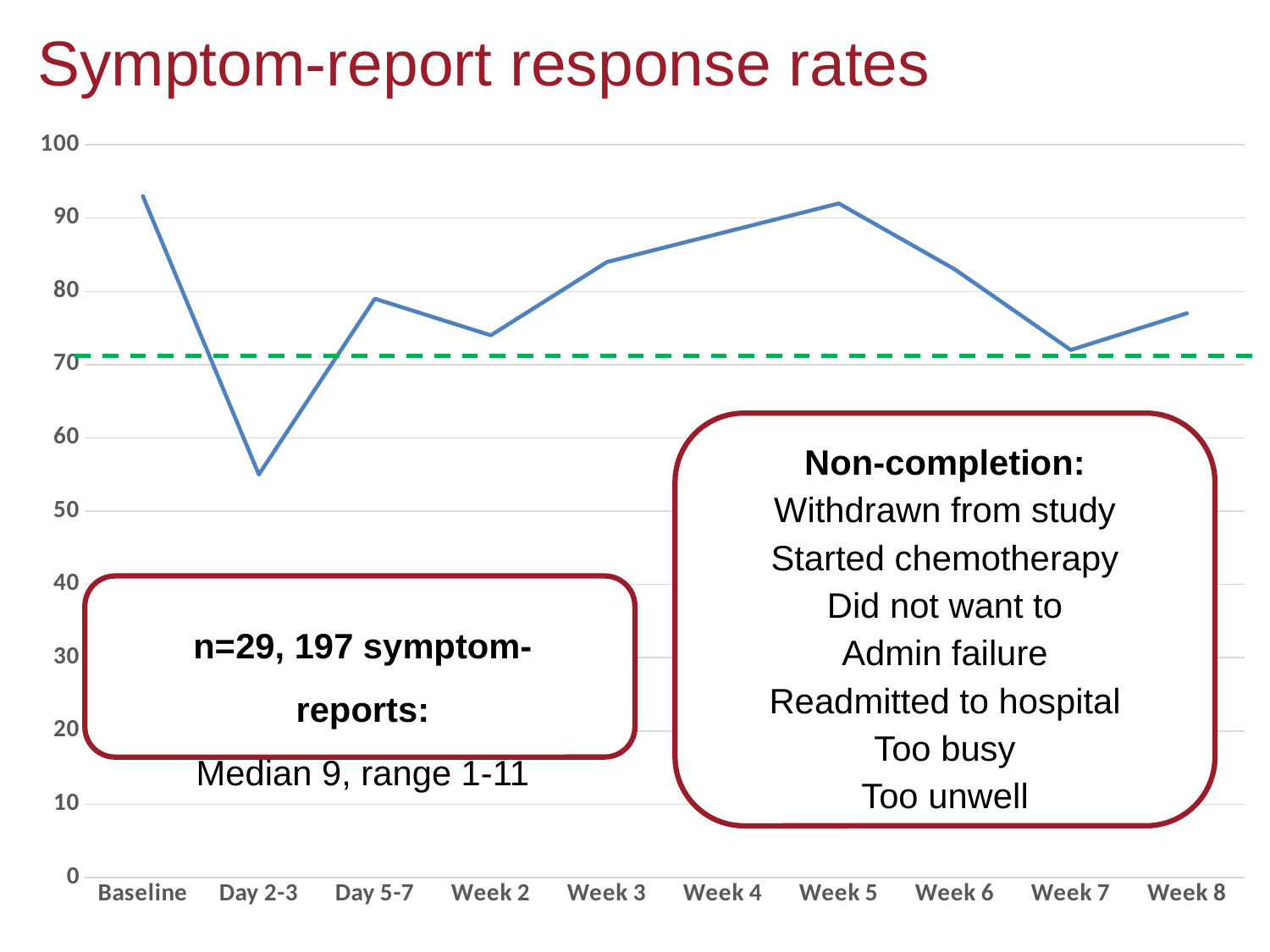
Do the values rise or fall from Week 5 to Week 7? fall Is the value for Day 2-3 greater or less than 60? less Is the value for Baseline greater or less than 90? greater How many time points are plotted along the x axis? 10 Which time point has the lowest response rate? Day 2-3 What kind of chart is shown on the slide? line chart Is the value for Week 7 greater or less than 80? less Which has the higher response rate, Week 2 or Week 3? Week 3 What is the title of the chart? Symptom-report response rates Which has the higher response rate, Day 2-3 or Day 5-7? Day 5-7